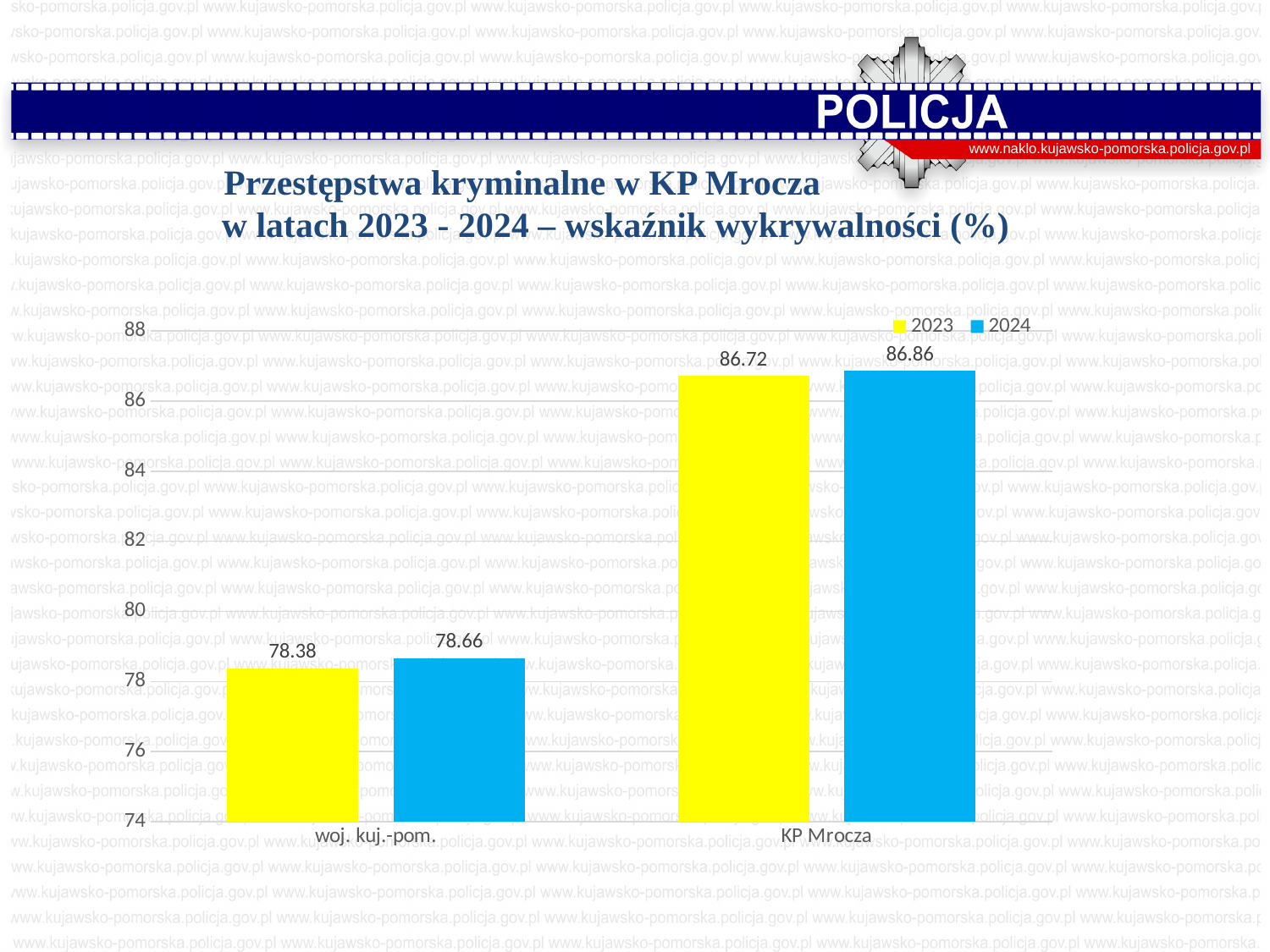
How many series does the legend list? 2 What is the difference between the 2024 and 2023 values for KP Mrocza? 0.14 What is the 2023 value for woj. kuj.-pom.? 78.38 What kind of chart is shown on the slide? bar chart What is the 2023 value for KP Mrocza? 86.72 How many categories are shown on the x axis? 2 What is the 2024 value for KP Mrocza? 86.86 Which is larger: the 2023 value for KP Mrocza or the 2024 value for woj. kuj.-pom.? 2023 value for KP Mrocza What is the difference between the 2024 value for KP Mrocza and the 2024 value for woj. kuj.-pom.? 8.20 Which category has the lowest 2023 value? woj. kuj.-pom. What is the 2024 value for woj. kuj.-pom.? 78.66 Which category has the highest 2024 value? KP Mrocza